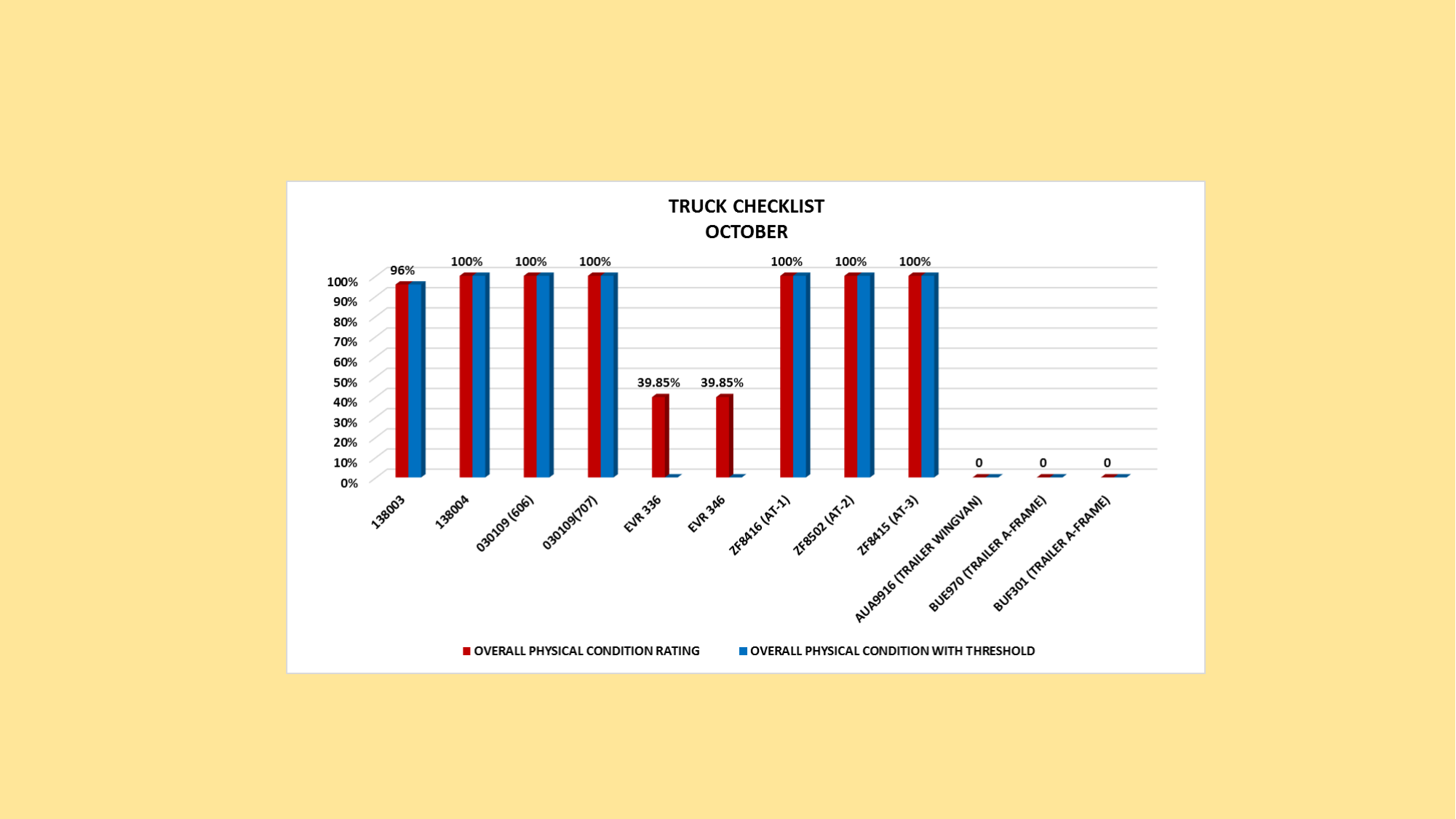
Which has the higher Overall Physical Condition Rating, ZF8416 (AT-1) or EVR 336? ZF8416 (AT-1) What is the title of the chart? TRUCK CHECKLIST OCTOBER What is the difference between the Overall Physical Condition Rating for ZF8502 (AT-2) and for EVR 346? 60.15% What is the Overall Physical Condition Rating for 138003? 96% Is the Overall Physical Condition With Threshold value for EVR 336 greater or less than 10%? less What value is labelled for AUA9916 (TRAILER WINGVAN)? 0 What kind of chart is shown on the slide? Bar chart What is the Overall Physical Condition Rating for EVR 336? 39.85% How many series does the legend list? 2 What is the difference between the Overall Physical Condition Rating for 138004 and for 138003? 4% How many categories are shown on the x axis? 12 Is the Overall Physical Condition Rating for EVR 346 greater or less than 50%? less